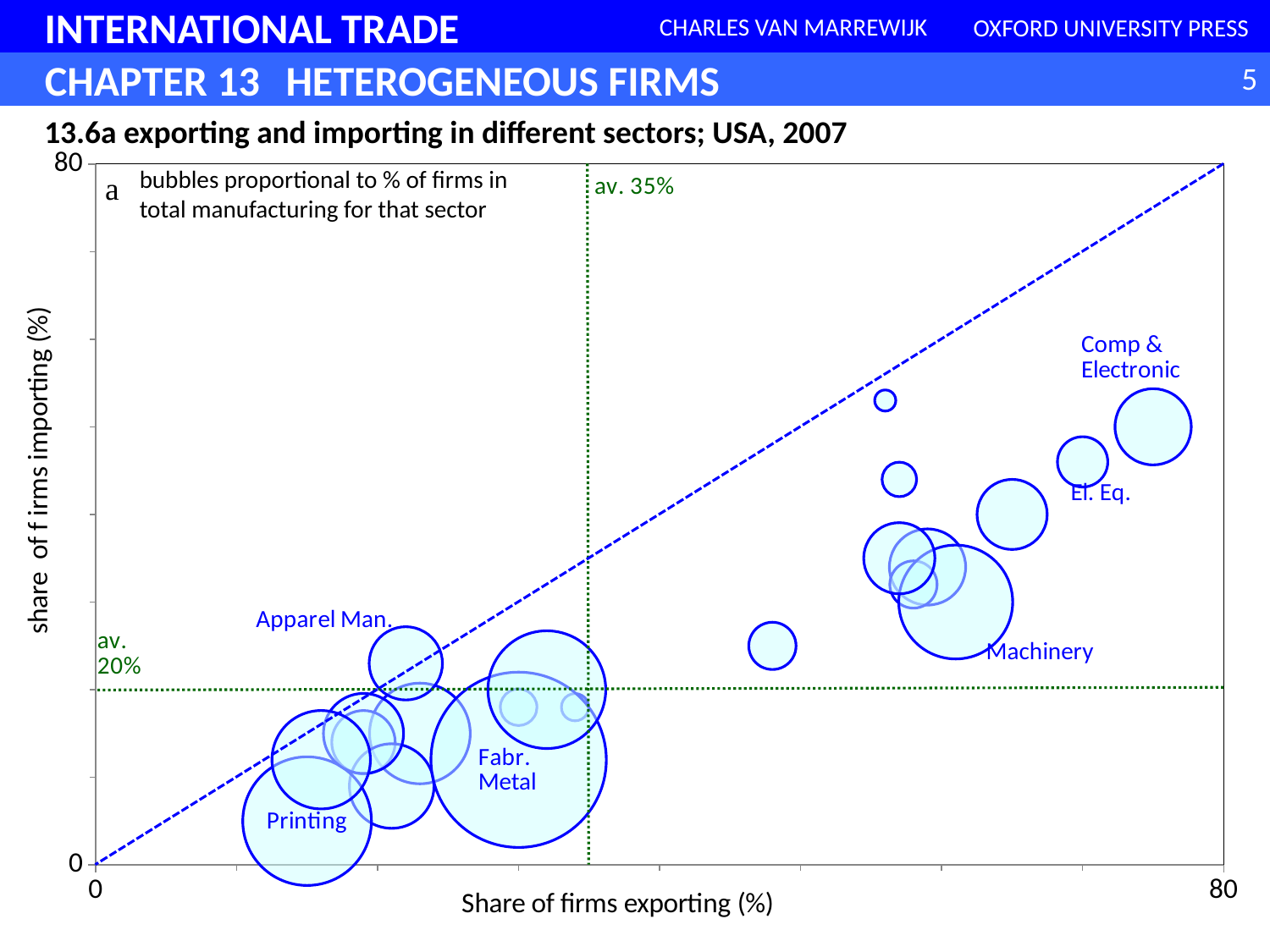
What is the title of the chart? 13.6a exporting and importing in different sectors; USA, 2007 According to the chart annotation, what are the bubble sizes proportional to? % of firms in total manufacturing for that sector Is the share of firms exporting for Apparel Man. greater or less than 40? less Is the share of firms exporting for Comp & Electronic greater or less than 40? greater Which has a higher share of firms importing, Comp & Electronic or Machinery? Comp & Electronic How many sectors are labeled by name on the chart? 6 What average share of firms importing is marked by the horizontal dotted line? av. 20% Which labeled sector has the highest share of firms exporting? Comp & Electronic What average share of firms exporting is marked by the vertical dotted line? av. 35% Which labeled sector has the lowest share of firms exporting? Printing Is the share of firms importing for Printing greater or less than 20? less What kind of chart is shown on the slide? bubble chart